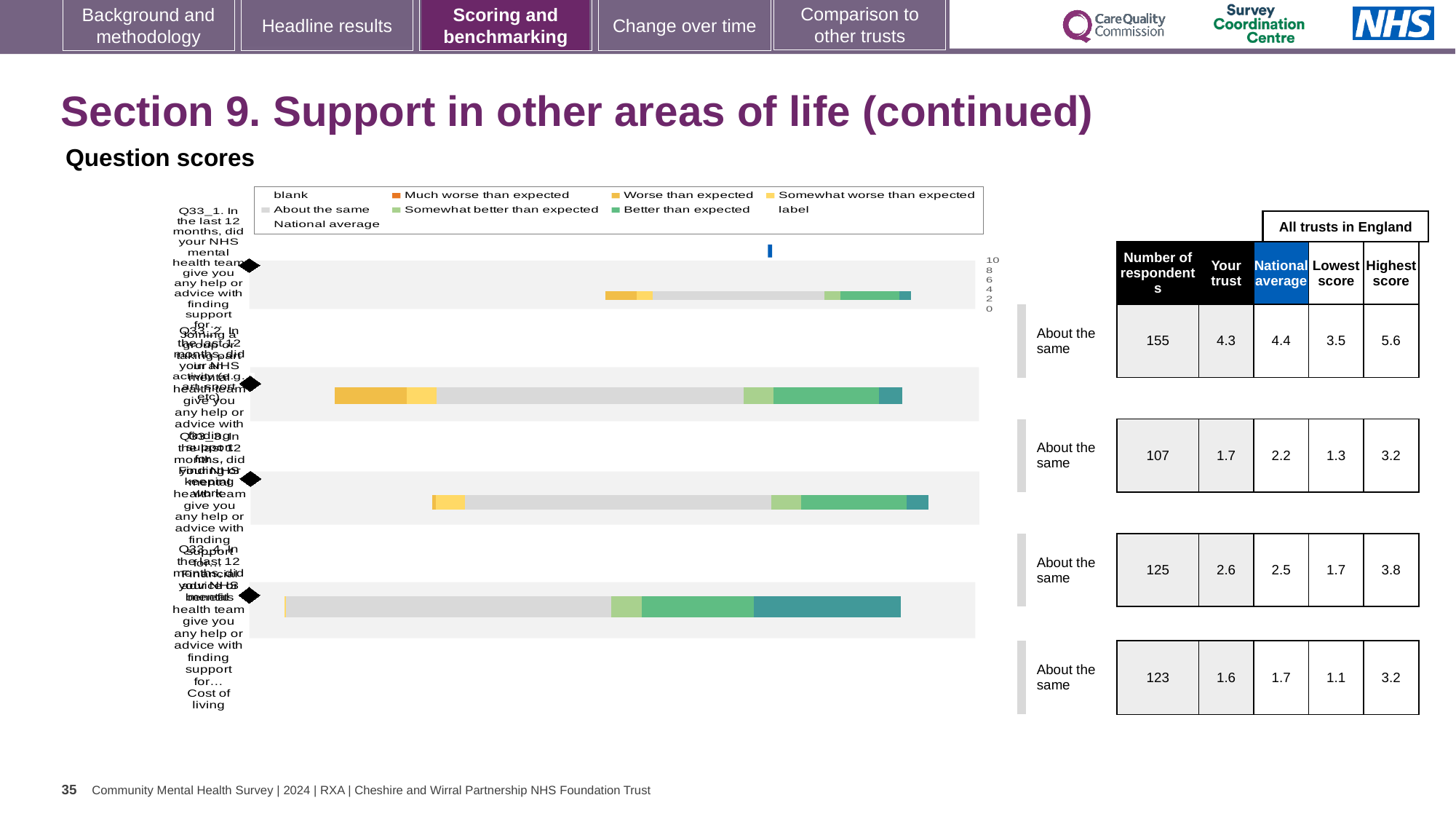
For Q33_3, which is larger: the 'Your trust' score or the national average? Your trust Which question has the highest 'Your trust' score in the table beside the chart? Q33_1 In the table next to the chart, how many respondents are listed for Q33_1? 155 How many question bars are plotted in the chart? 4 What is the 'Your trust' score for Q33_1 in the table beside the chart? 4.3 What kind of chart is shown under 'Question scores'? bar chart What is the highest score across all trusts in England for Q33_3? 3.8 What is the difference between the highest score (5.6) and the lowest score (3.5) for Q33_1? 2.1 What is the national average score for Q33_2 in the table beside the chart? 2.2 Which question has the fewest respondents in the table beside the chart? Q33_2 What is the lowest score across all trusts in England for Q33_4? 1.1 What benchmark label is shown next to each of the four question bars? About the same